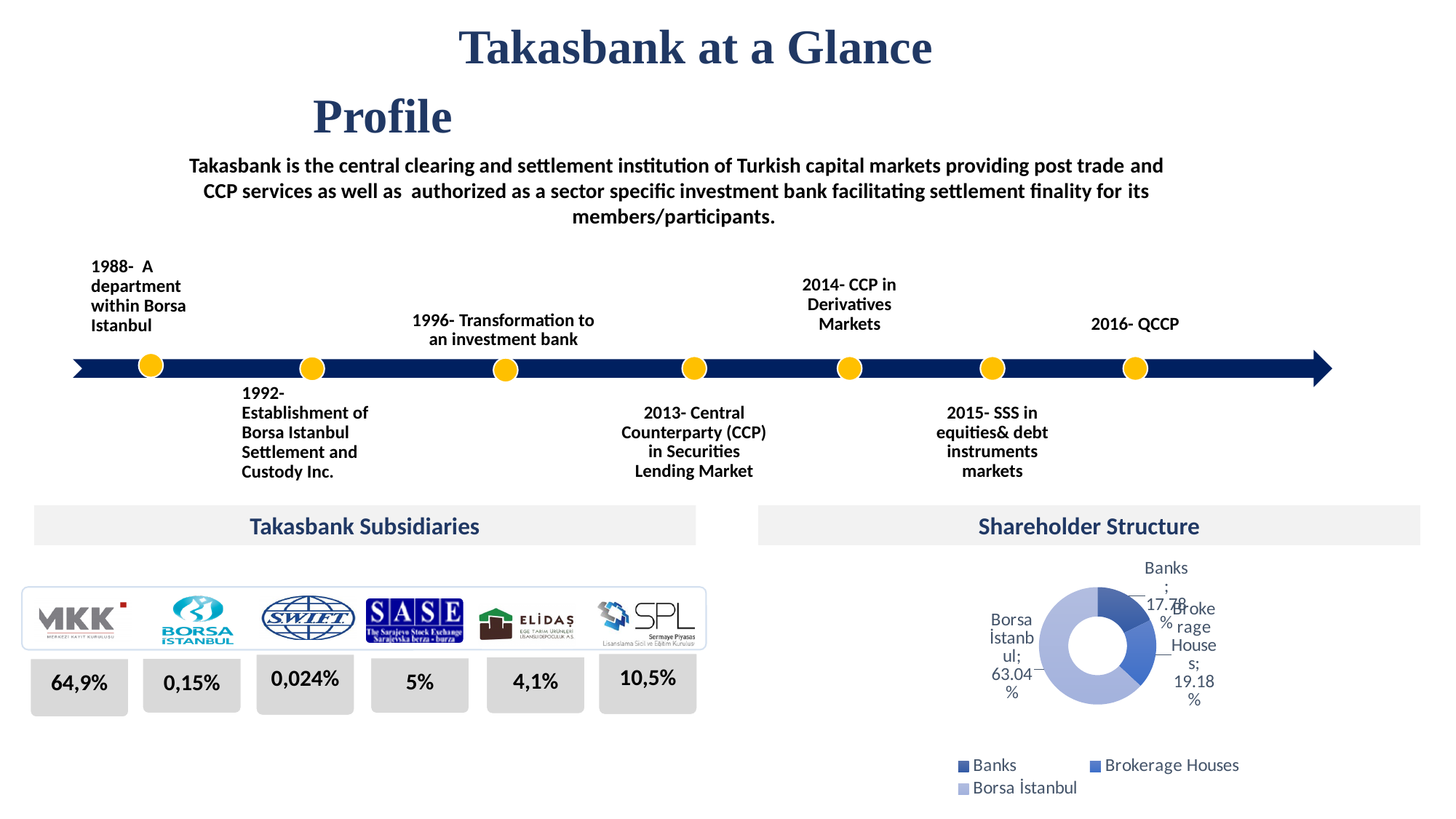
In the Shareholder Structure chart, what share is shown for Borsa İstanbul? 63.04% What are the three legend entries of the Shareholder Structure chart? Banks, Brokerage Houses, Borsa İstanbul In the Shareholder Structure chart, which is larger: the share of Borsa İstanbul or the share of Brokerage Houses? Borsa İstanbul In the Shareholder Structure chart, how many percentage points larger is the Borsa İstanbul share than the Brokerage Houses share? 43.86 What kind of chart is used for the Shareholder Structure? Doughnut chart How many shareholder groups are shown in the Shareholder Structure chart? 3 What is the title of the chart on the right side of the slide? Shareholder Structure How many entries does the legend of the Shareholder Structure chart list? 3 In the Shareholder Structure chart, what share is shown for Brokerage Houses? 19.18% In the Shareholder Structure chart, which shareholder group holds the largest share? Borsa İstanbul In the Shareholder Structure chart, which shareholder group holds the smallest share? Banks